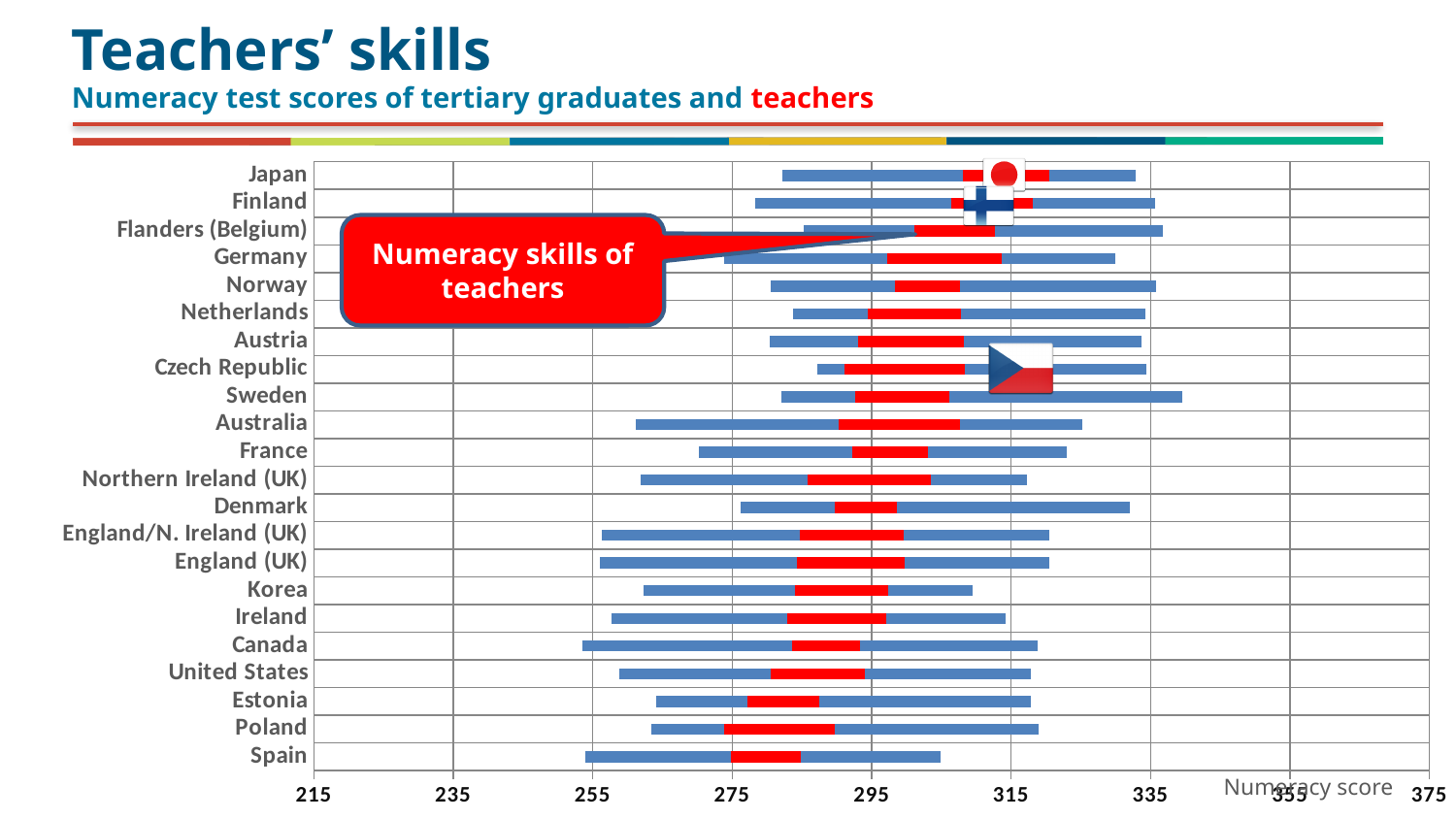
Is the red (teachers) bar for Japan positioned greater or less than 295 on the numeracy score axis? greater Which country's red (teachers) bar lies further to the right on the axis, Japan or Spain? Japan Which country's red (teachers) bar lies further to the right on the axis, Germany or Estonia? Germany Is the left end of the blue bar for Japan greater or less than 275? greater What is the label of the horizontal axis of the chart? Numeracy score What colour are the bars representing teachers' numeracy skills? Red Is the right end of the blue bar for Sweden greater or less than 335? greater How many countries or regions are listed on the vertical axis of the chart? 22 What kind of chart is shown on the slide? Bar chart Moving down the list from Japan to Spain, do the red (teachers) bars generally shift to higher or lower numeracy scores? Lower